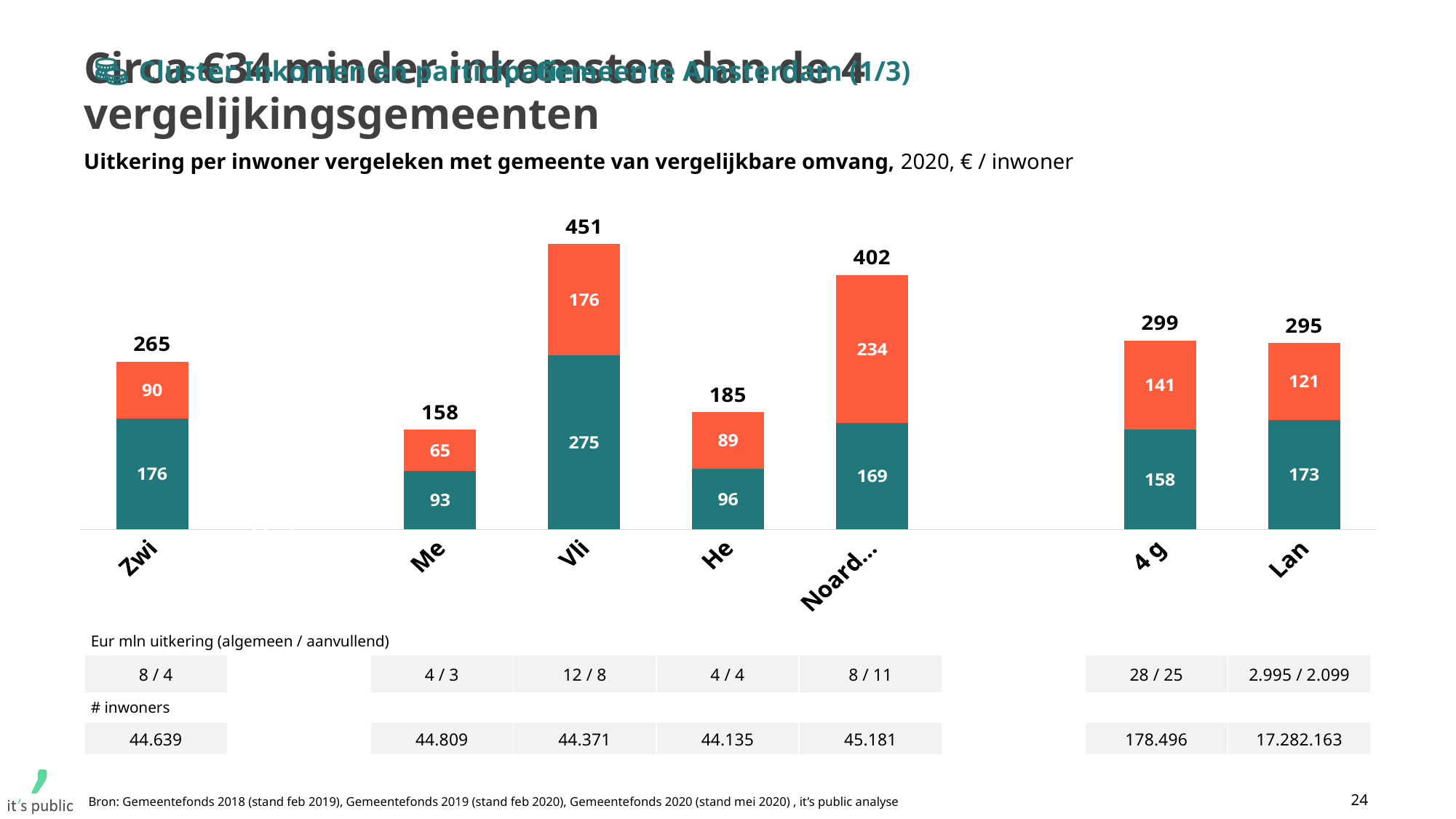
What unit is stated in the chart subtitle for the plotted values? € / inwoner Which category has the lowest total value? Me What is the difference between the total for Vli and the total for Noard...? 49 What is the difference between the teal segment and the orange segment of the bar for Me? 28 What is the total value shown above the bar for Vli? 451 Which category has the highest total value? Vli Which has a larger total, 4 g or Lan? 4 g What is the sum of the two segments of the bar for He? 185 What is the value of the orange (top) segment of the bar for Noard...? 234 How many bars are shown in the chart? 7 What is the value of the teal (bottom) segment of the bar for Zwi? 176 What type of chart is shown on the slide? Stacked bar chart